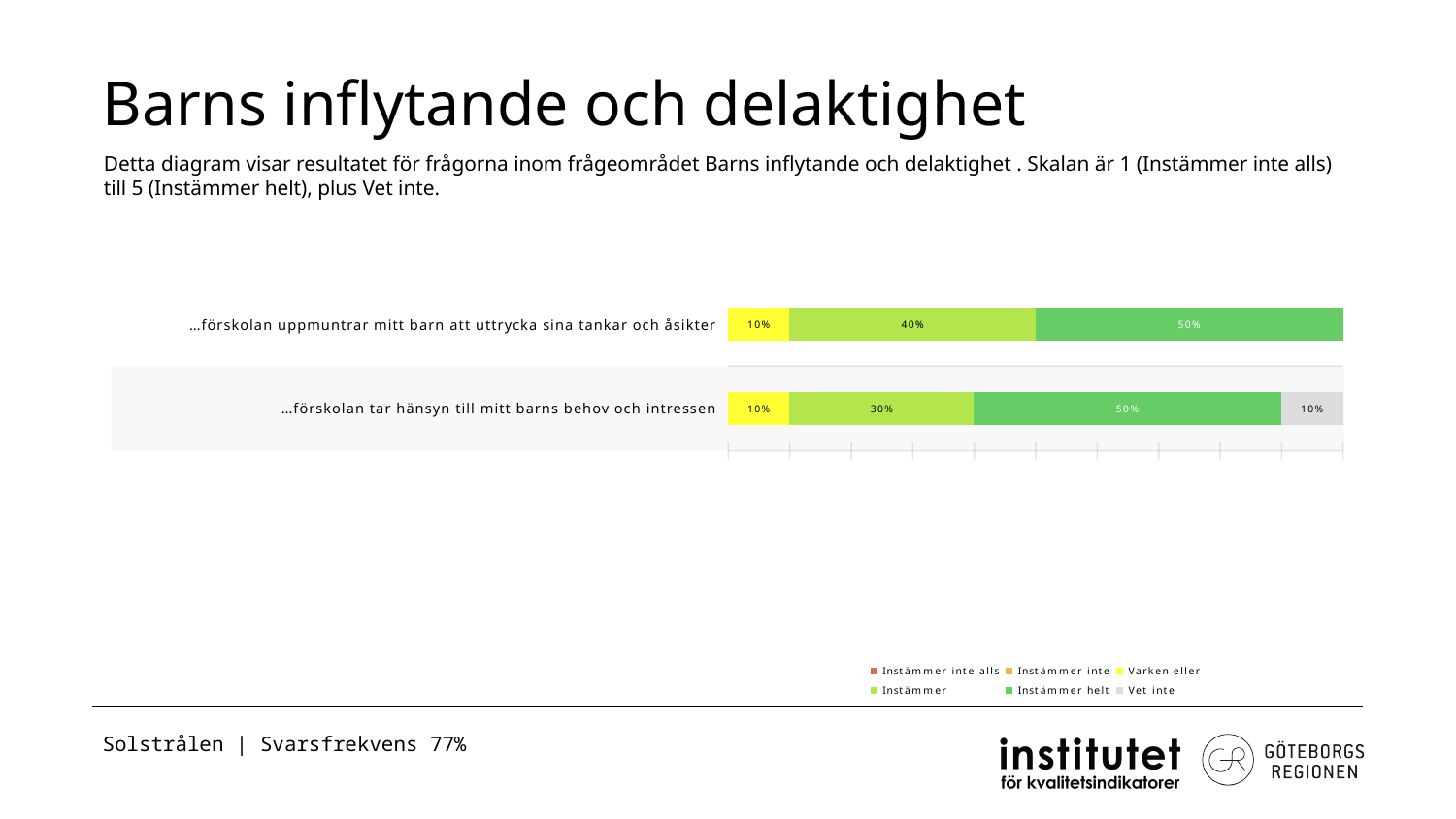
How many series does the legend list? 6 What is the combined share of "Instämmer" and "Instämmer helt" for "…förskolan tar hänsyn till mitt barns behov och intressen"? 80% What is the title of the slide containing the chart? Barns inflytande och delaktighet What is the difference between the "Instämmer" values for "…förskolan uppmuntrar mitt barn att uttrycka sina tankar och åsikter" and "…förskolan tar hänsyn till mitt barns behov och intressen"? 10% Which legend entry is shown in grey? Vet inte How many categories (questions) are plotted in the chart? 2 Which category has the larger "Instämmer" value? …förskolan uppmuntrar mitt barn att uttrycka sina tankar och åsikter What is the "Instämmer helt" value for "…förskolan tar hänsyn till mitt barns behov och intressen"? 50% What kind of chart is shown on the slide? Stacked bar chart What is the "Varken eller" value for "…förskolan uppmuntrar mitt barn att uttrycka sina tankar och åsikter"? 10% What is the "Vet inte" value for "…förskolan tar hänsyn till mitt barns behov och intressen"? 10% What is the "Instämmer" value for "…förskolan uppmuntrar mitt barn att uttrycka sina tankar och åsikter"? 40%